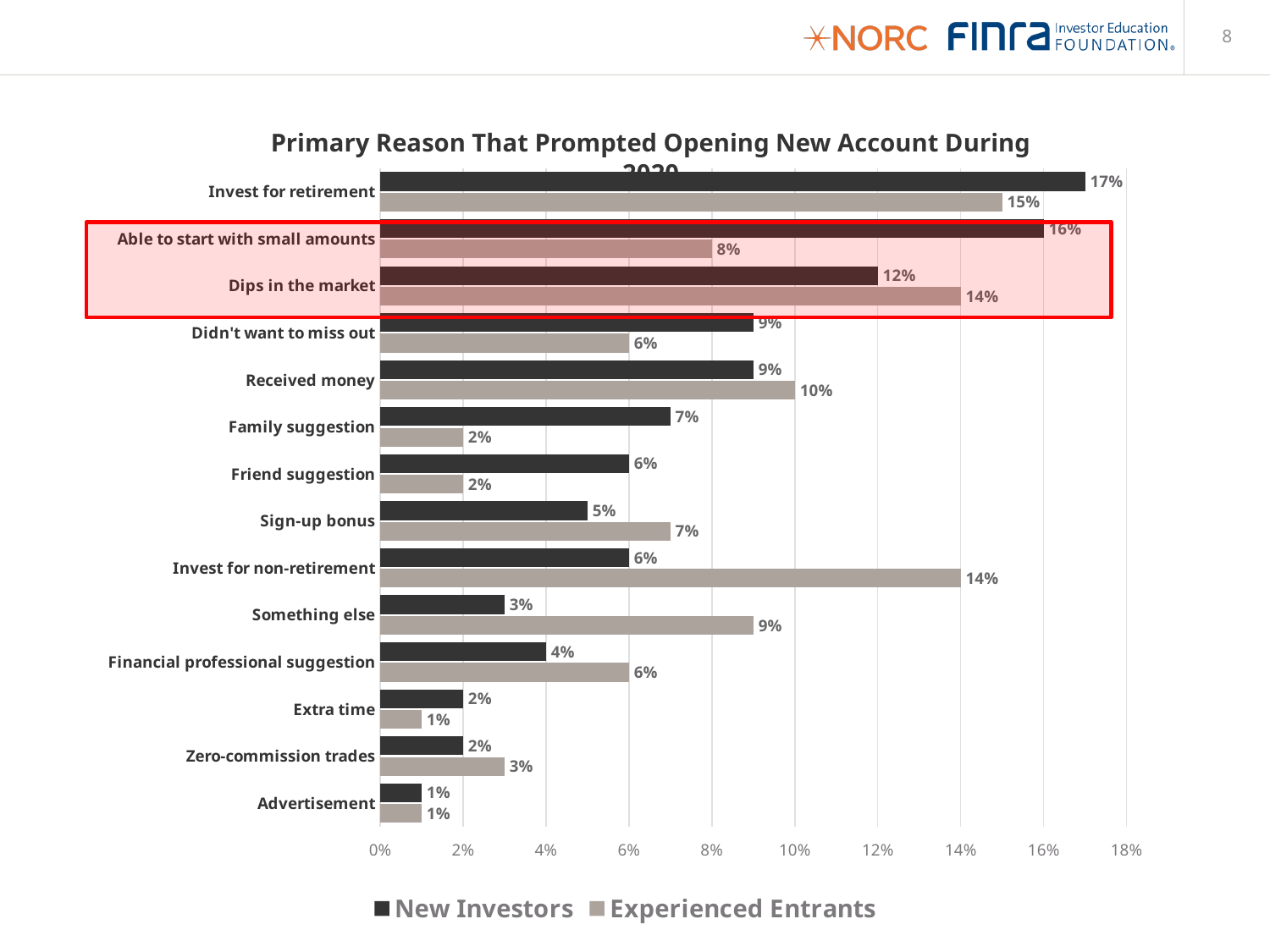
What is the New Investors value for Something else? 3% What is the difference between the New Investors and Experienced Entrants values for Able to start with small amounts? 8% How many categories are shown on the chart? 14 How many series does the legend list? 2 What is the Experienced Entrants value for Invest for non-retirement? 14% What are the two series named in the legend? New Investors and Experienced Entrants What is the New Investors value for Able to start with small amounts? 16% What kind of chart is shown on the slide? Bar chart Which category has the highest New Investors value? Invest for retirement What is the Experienced Entrants value for Dips in the market? 14% For Sign-up bonus, which series has the larger value, New Investors or Experienced Entrants? Experienced Entrants Which category has the lowest New Investors value? Advertisement